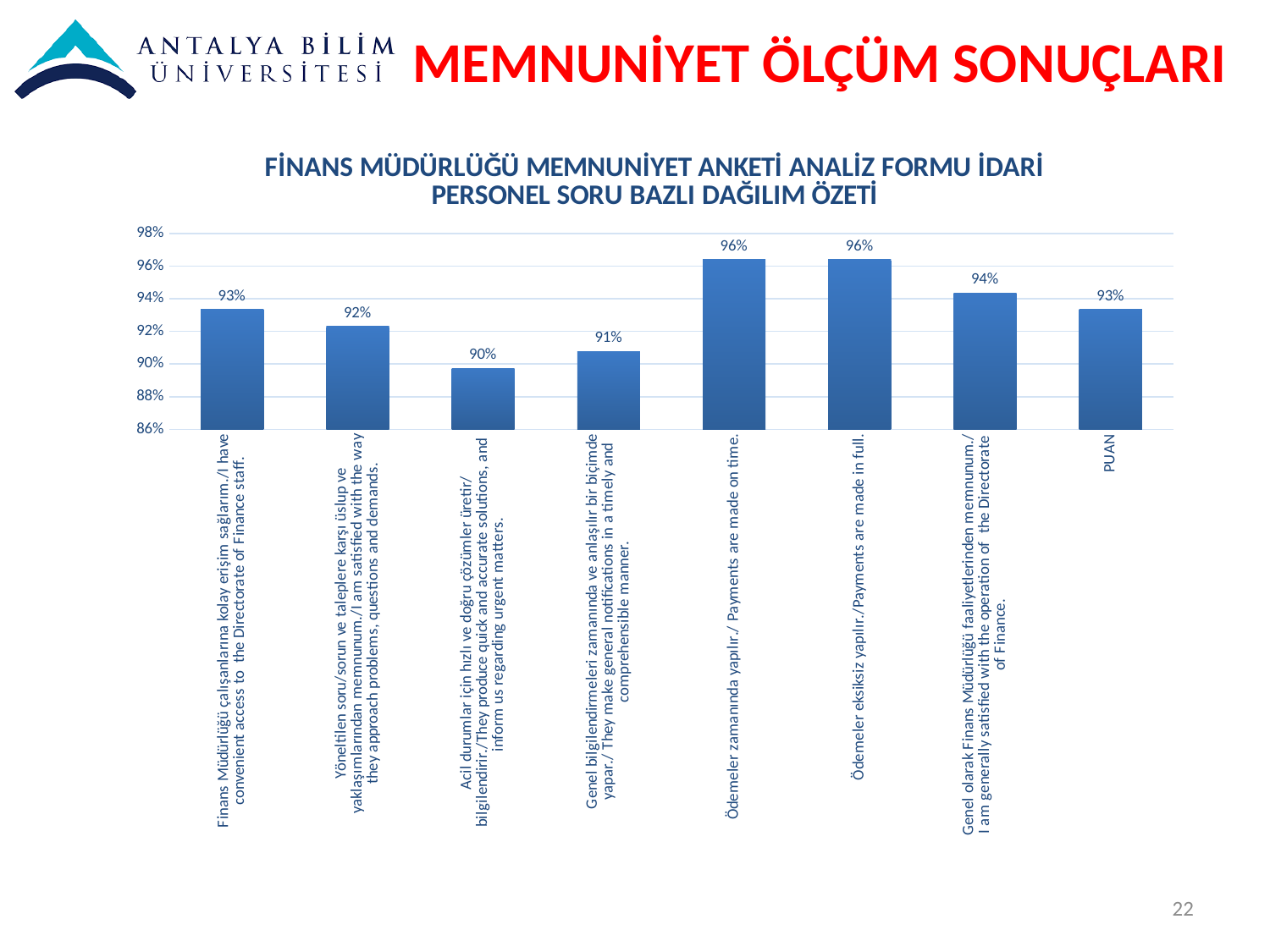
What is the value for the category 'PUAN'? 93% Which is larger: the value for 'Yöneltilen soru/sorun ve taleplere karşı üslup ve yaklaşımlarından memnunum./I am satisfied with the way they approach problems, questions and demands.' or the value for 'Genel bilgilendirmeleri zamanında ve anlaşılır bir biçimde yapar./ They make general notifications in a timely and comprehensible manner.'? Yöneltilen soru/sorun ve taleplere karşı üslup ve yaklaşımlarından memnunum./I am satisfied with the way they approach problems, questions and demands. What is the highest value shown in the chart? 96% How many bars are plotted in the chart? 8 Which category has the lowest value in the chart? Acil durumlar için hızlı ve doğru çözümler üretir/bilgilendirir./They produce quick and accurate solutions, and inform us regarding urgent matters. What is the value for 'Genel olarak Finans Müdürlüğü faaliyetlerinden memnunum./ I am generally satisfied with the operation of the Directorate of Finance.'? 94% What is the value for 'Acil durumlar için hızlı ve doğru çözümler üretir/bilgilendirir./They produce quick and accurate solutions, and inform us regarding urgent matters.'? 90% What kind of chart is shown on the slide? bar chart What is the title of the chart? FİNANS MÜDÜRLÜĞÜ MEMNUNİYET ANKETİ ANALİZ FORMU İDARİ PERSONEL SORU BAZLI DAĞILIM ÖZETİ What is the difference between the value for 'Ödemeler eksiksiz yapılır./Payments are made in full.' and the value for 'PUAN'? 3 percentage points Is the value for 'Ödemeler eksiksiz yapılır./Payments are made in full.' greater or less than 94%? greater What is the value for 'Ödemeler zamanında yapılır./ Payments are made on time.'? 96%